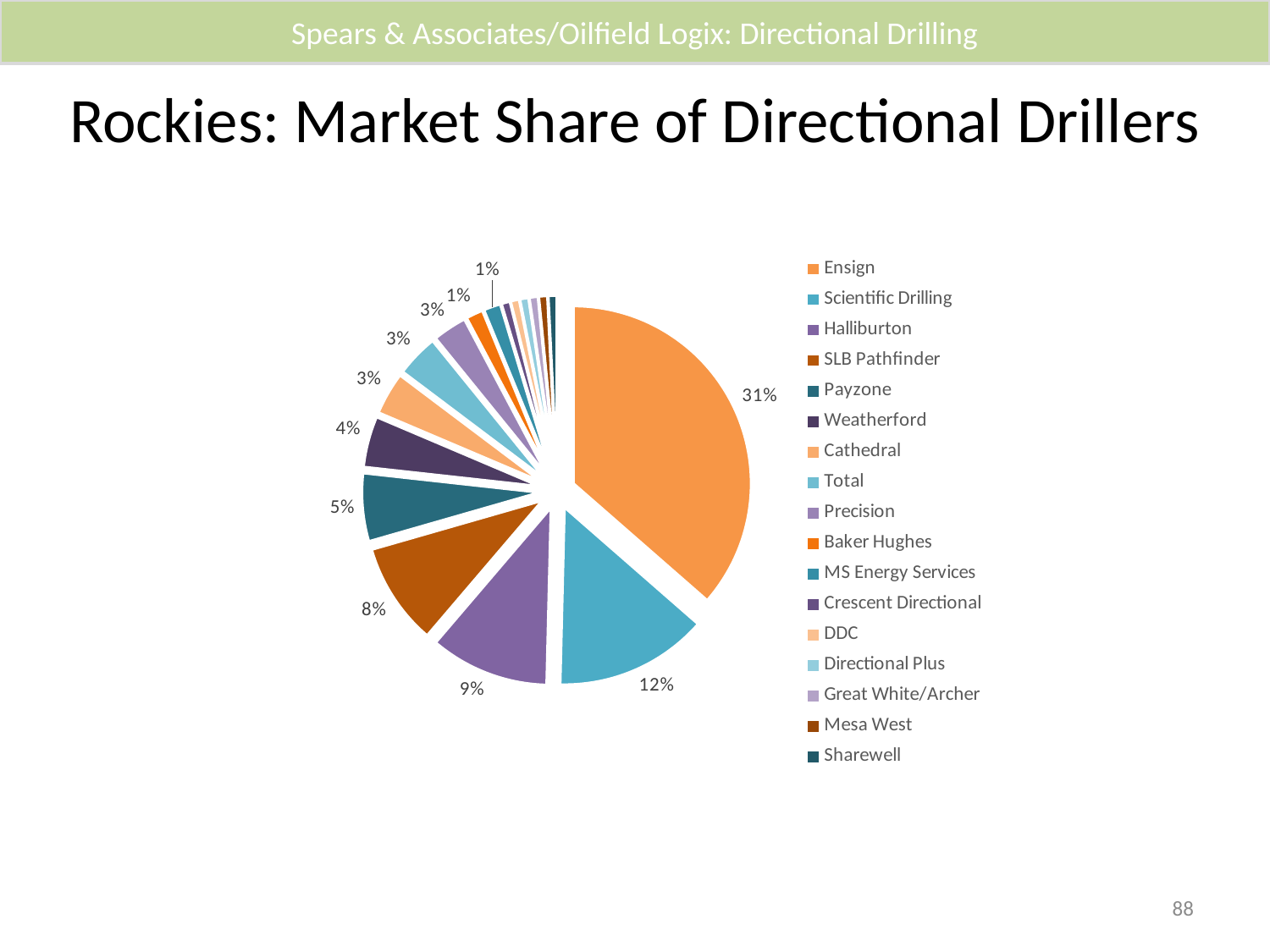
How many percentage points larger is Ensign's share than Scientific Drilling's share? 19 percentage points What is the market share of Weatherford? 4% What is the market share of Payzone? 5% What kind of chart is shown on the slide? Pie chart How many drillers are listed in the legend of the pie chart? 17 What is the title of the chart on the slide? Rockies: Market Share of Directional Drillers What is the market share of Scientific Drilling? 12% Which has the larger market share, Halliburton or SLB Pathfinder? Halliburton What is the market share of SLB Pathfinder? 8% What is the market share of Ensign? 31% What is the market share of Halliburton? 9% Which driller has the largest market share in the pie chart? Ensign